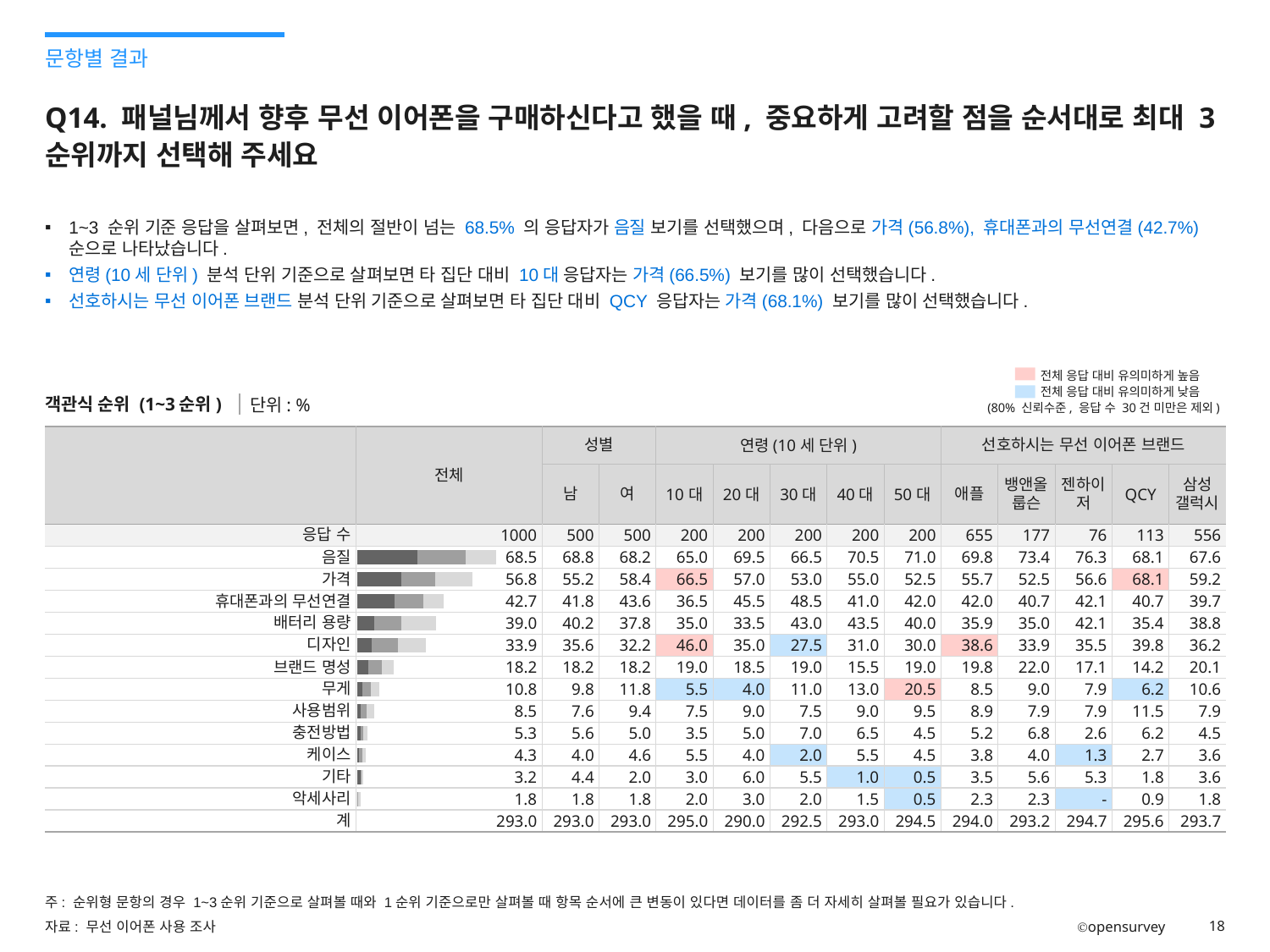
Which category has the highest overall (전체) value in the bar chart? 음질 Which category has the lowest overall (전체) value in the bar chart? 악세사리 What is the overall (전체) value for 휴대폰과의 무선연결 in the bar chart? 42.7 What is the overall (전체) value for 가격 in the bar chart? 56.8 What is the overall (전체) value for 음질 in the bar chart? 68.5 What is the difference between the overall (전체) values for 음질 and 가격? 11.7 What unit is used for the values in the bar chart? % Which has the larger overall (전체) value, 배터리 용량 or 디자인? 배터리 용량 What is the overall (전체) value for 무게 in the bar chart? 10.8 How many categories are plotted in the bar chart? 12 Do the overall (전체) bar values rise or fall going from the top category to the bottom category? fall What kind of chart is shown in the 전체 column? bar chart